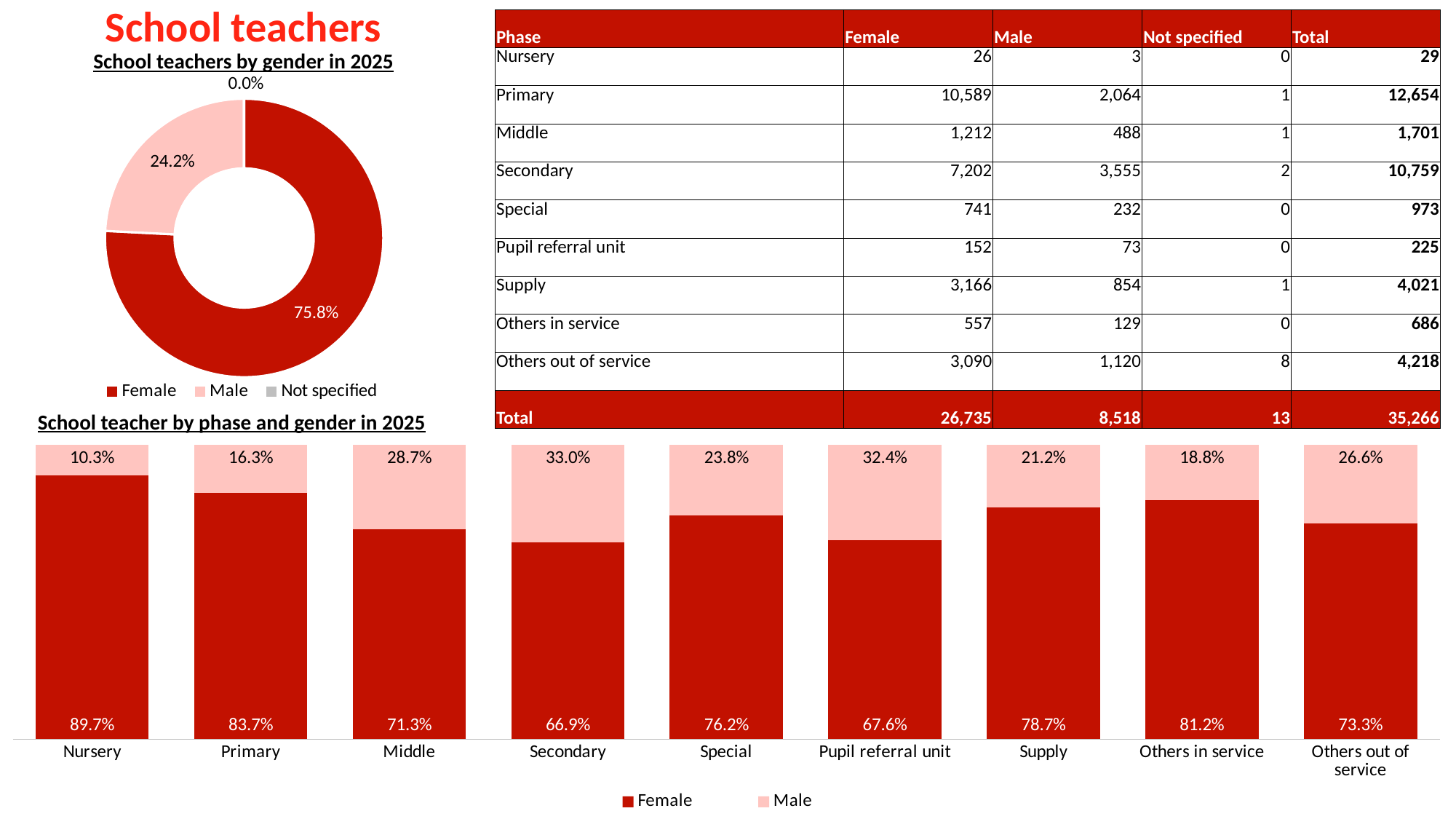
In the 'School teachers by gender in 2025' chart, what share of school teachers are male? 24.2% How many entries does the legend of the 'School teachers by gender in 2025' chart list? 3 In the 'School teacher by phase and gender in 2025' chart, which phase has the highest Female percentage? Nursery In the 'School teacher by phase and gender in 2025' chart, which has a larger Male percentage, Supply or Special? Special What kind of chart is 'School teachers by gender in 2025'? Doughnut (pie) chart What kind of chart is 'School teacher by phase and gender in 2025'? Stacked bar chart In the 'School teachers by gender in 2025' chart, what share of school teachers are female? 75.8% In the 'School teacher by phase and gender in 2025' chart, what is the Male percentage for Secondary? 33.0% In the 'School teacher by phase and gender in 2025' chart, what is the difference between the Female percentages for Primary and Middle? 12.4% In the 'School teacher by phase and gender in 2025' chart, what is the Female percentage for Nursery? 89.7% How many phases are shown on the x axis of the 'School teacher by phase and gender in 2025' chart? 9 In the 'School teacher by phase and gender in 2025' chart, which phase has the lowest Female percentage? Secondary